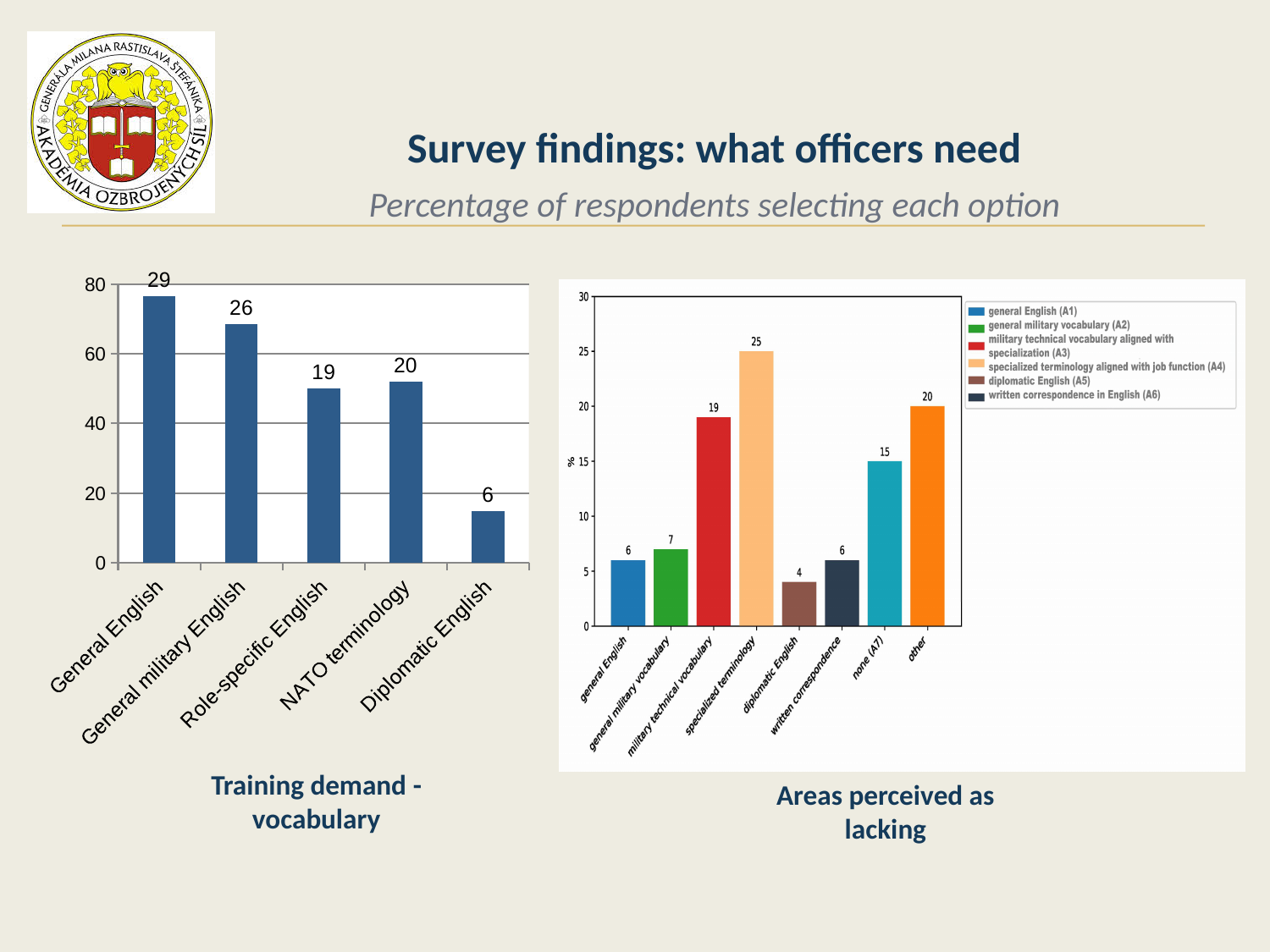
How many entries does the legend of the 'Areas perceived as lacking' chart list? 6 In the 'Training demand - vocabulary' chart, which category has the lowest value? Diplomatic English In the 'Areas perceived as lacking' chart, what is the value for specialized terminology? 25 In the 'Areas perceived as lacking' chart, which category has the highest value? specialized terminology In the 'Areas perceived as lacking' chart, what is the difference between 'other' and 'none (A7)'? 5 What kind of chart is the 'Areas perceived as lacking' chart? bar chart In the 'Training demand - vocabulary' chart, which is larger: Role-specific English or NATO terminology? NATO terminology In the 'Training demand - vocabulary' chart, what is the value for General English? 29 How many categories are shown on the x axis of the 'Areas perceived as lacking' chart? 8 In the 'Training demand - vocabulary' chart, what is the difference between General English and General military English? 3 In the 'Areas perceived as lacking' chart, what is the value for diplomatic English? 4 How many categories are shown in the 'Training demand - vocabulary' chart? 5